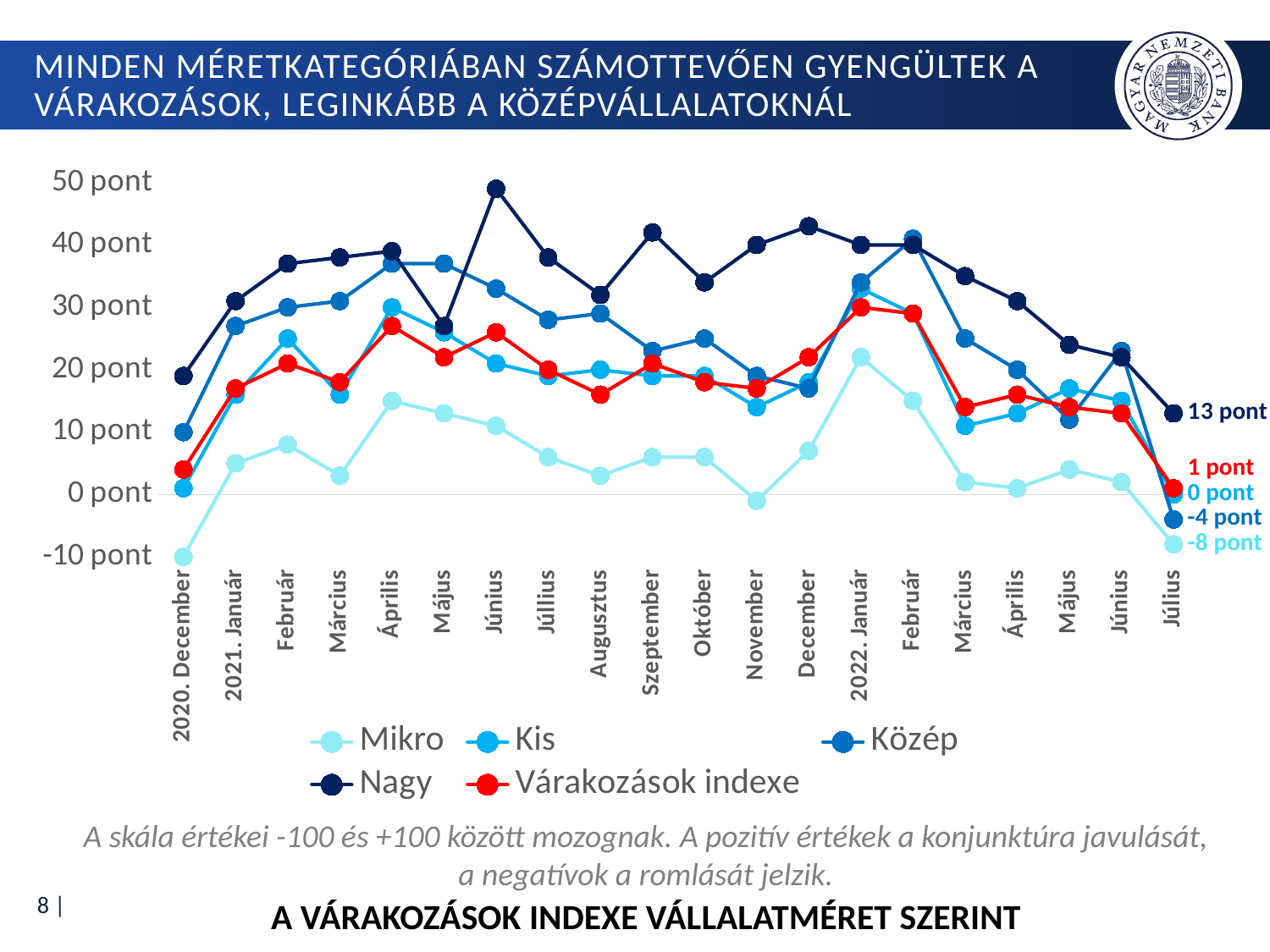
How many months are shown on the x axis? 20 What kind of chart is shown on the slide? line chart How many series does the legend list? 5 What is the difference between the Nagy and Mikro values in 2022 Július? 21 pont What is the value of the Várakozások indexe series in 2022 Július? 1 pont What is the value of the Közép series in 2022 Július? -4 pont Which series has the highest value in 2022 Július? Nagy Does the Nagy series rise or fall from 2022 Február to 2022 Július? fall What is the value of the Nagy series in 2022 Július? 13 pont Is the value of the Nagy series in 2021 Június greater or less than 40 pont? greater Which series has the lowest value in 2022 Július? Mikro What is the value of the Mikro series in 2022 Július? -8 pont